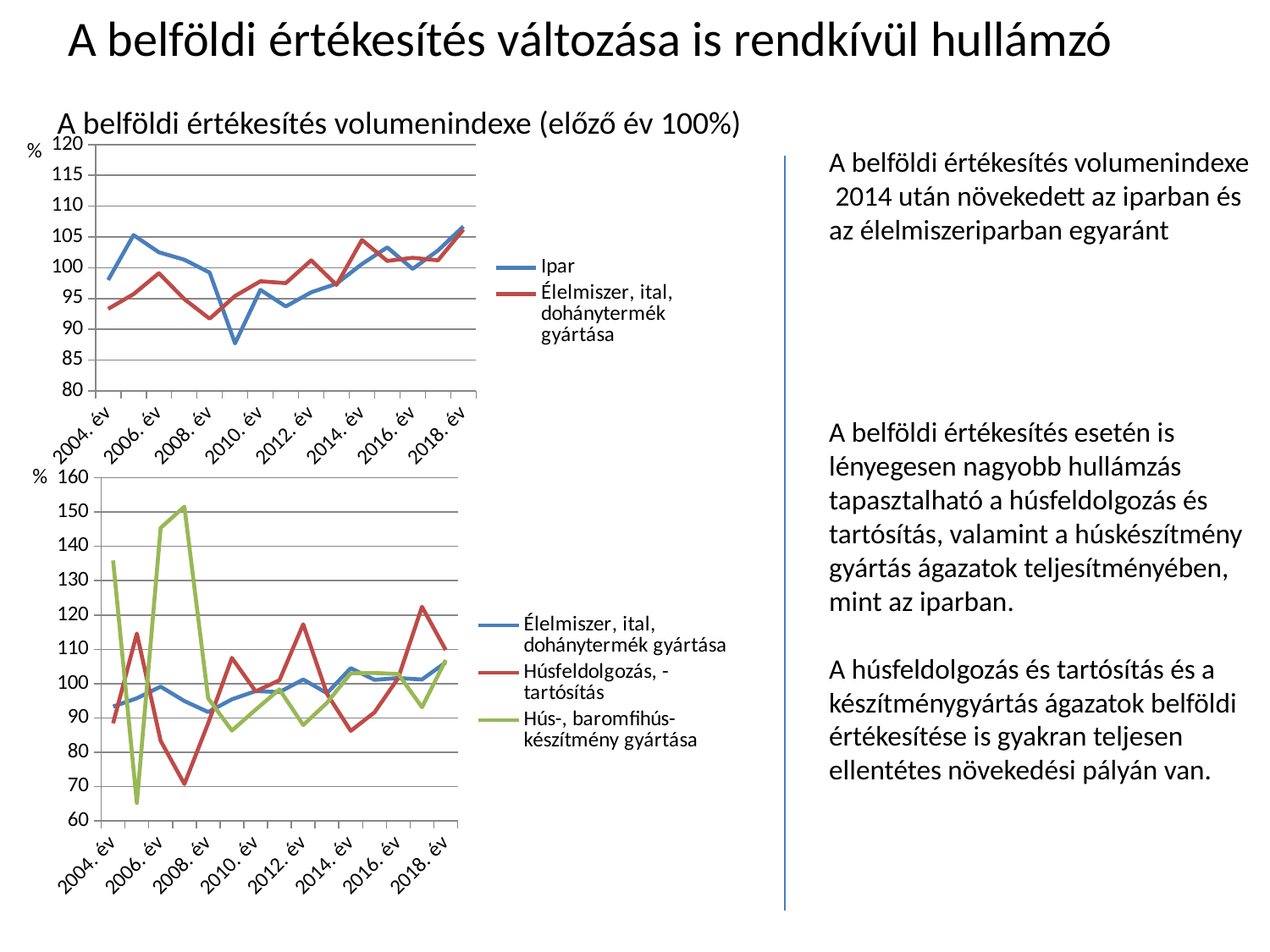
In the top chart, is the value for Ipar in 2018. év greater or less than 105? greater In the bottom chart, which series reaches the lowest value on the chart? Hús-, baromfihús-készítmény gyártása How many series does the legend of the bottom chart list? 3 In the bottom chart, which series reaches the highest value on the chart? Hús-, baromfihús-készítmény gyártása In the top chart, is the value for Ipar in 2006. év greater or less than 100? greater What unit is shown on the vertical axis of the top chart? % In the top chart, does the Ipar line rise or fall from 2006. év to 2008. év? fall What kind of chart is the top chart, 'A belföldi értékesítés volumenindexe (előző év 100%)'? line chart In the bottom chart, is the value for Hús-, baromfihús-készítmény gyártása in 2004. év greater or less than 130? greater How many series does the legend of the top chart list? 2